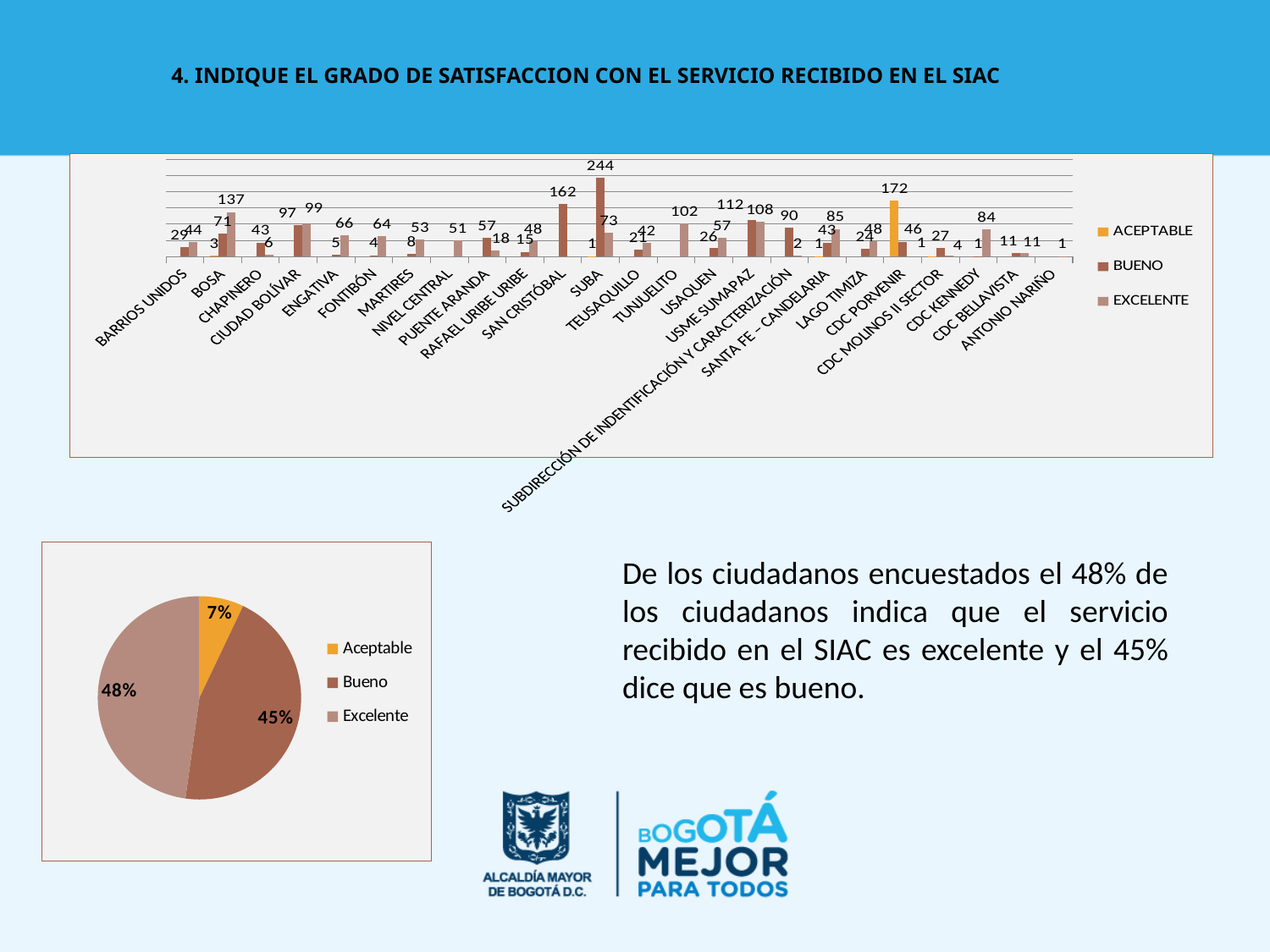
In the top bar chart, what is the ACEPTABLE value for CDC PORVENIR? 172 In the pie chart, which category has the largest slice? Excelente In the top bar chart, what is the BUENO value for BOSA? 71 How many series does the legend of the top bar chart list? 3 In the pie chart, what share of respondents rated the service Aceptable? 7% In the pie chart, what is the difference in percentage points between the Excelente and Bueno slices? 3 percentage points In the top bar chart, which category has the tallest bar? SUBA In the pie chart, which slice is larger, Bueno or Excelente? Excelente What type of chart is the chart at the bottom left of the slide? Pie chart In the pie chart, which category has the smallest slice? Aceptable In the top bar chart, what is the BUENO value for SUBA? 244 In the pie chart, what share of respondents rated the service Excelente? 48%